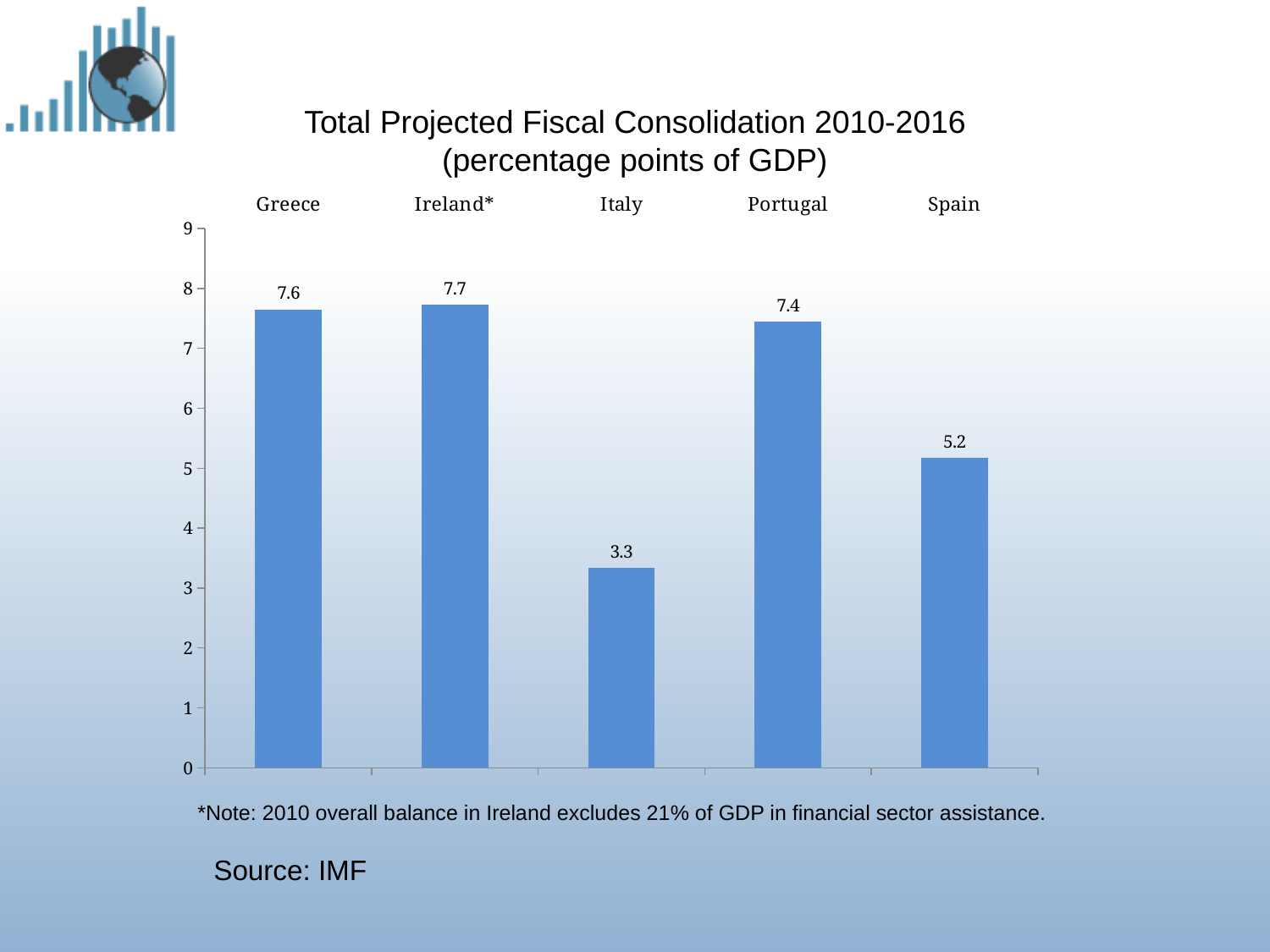
Which country has the highest value? Ireland* What is the value for Italy? 3.3 How many countries are shown in the chart? 5 What is the difference between the values for Greece and Spain? 2.4 What is the difference between the values for Ireland* and Italy? 4.4 What is the value for Spain? 5.2 Which country has the lowest value? Italy What kind of chart is shown on the slide? Bar chart Which is larger, the value for Portugal or the value for Spain? Portugal What is the title of the chart? Total Projected Fiscal Consolidation 2010-2016 (percentage points of GDP) What is the value for Greece? 7.6 What is the value for Portugal? 7.4